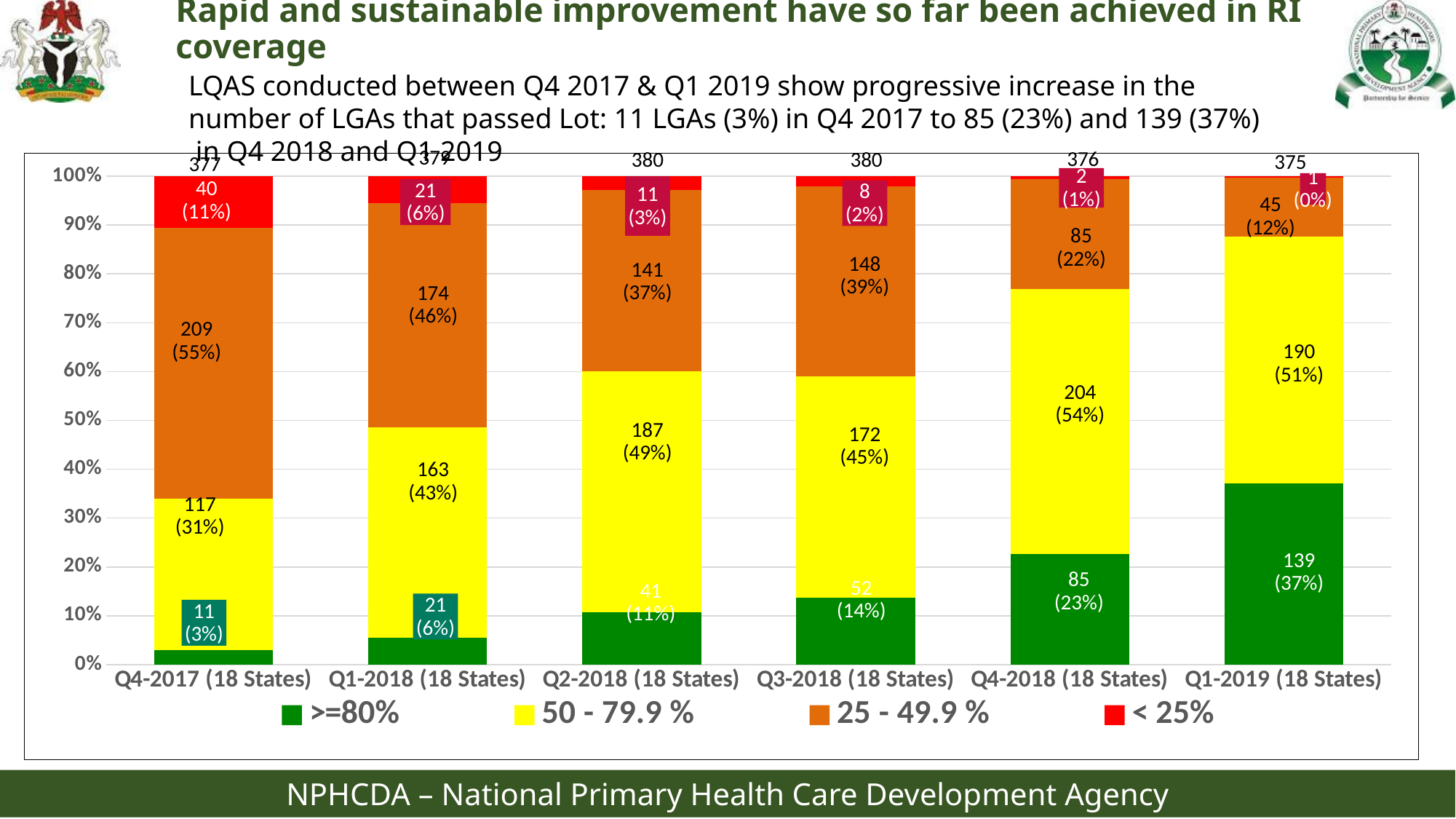
How many series does the legend list? 4 How many LGAs were in the >=80% category in Q1-2019 (18 States)? 139 (37%) What is the value for the 50 - 79.9 % series in Q4-2018 (18 States)? 204 (54%) Which quarter has more LGAs in the 50 - 79.9 % category, Q2-2018 (18 States) or Q3-2018 (18 States)? Q2-2018 (18 States) How many quarters are shown on the x axis of the chart? 6 What is the value for the 25 - 49.9 % series in Q4-2017 (18 States)? 209 (55%) Does the number of LGAs in the >=80% category rise or fall from Q4-2017 to Q1-2019? Rise Which quarter has the highest number of LGAs in the >=80% category? Q1-2019 (18 States) Which quarter has the lowest number of LGAs in the < 25% category? Q1-2019 (18 States) By how many LGAs did the >=80% category increase from Q4-2018 (18 States) to Q1-2019 (18 States)? 54 What kind of chart is shown on the slide? Stacked bar chart What is the value for the < 25% series in Q3-2018 (18 States)? 8 (2%)